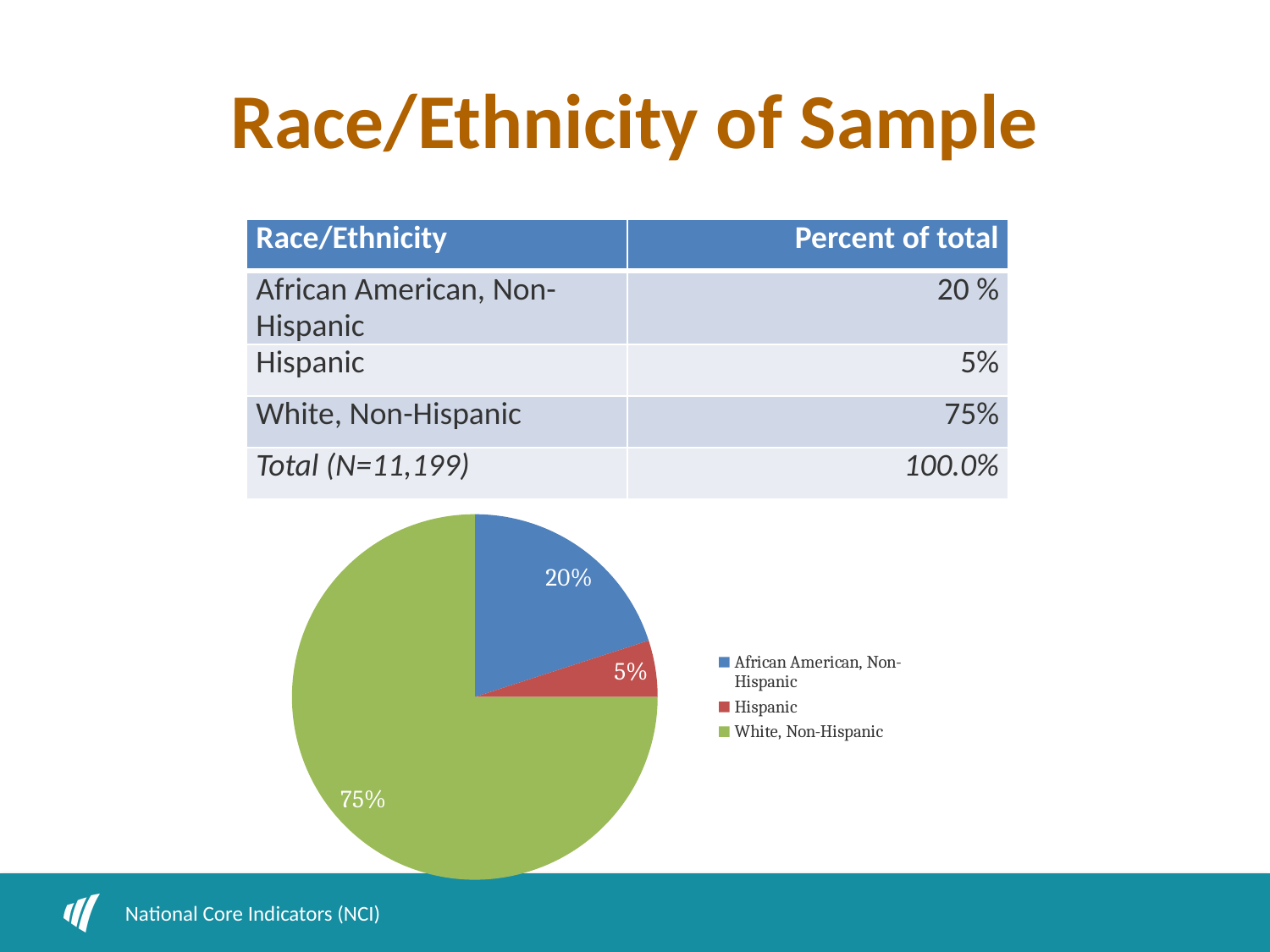
Which slice is larger: African American, Non-Hispanic or Hispanic? African American, Non-Hispanic Which category has the largest slice of the pie? White, Non-Hispanic What share of the pie does White, Non-Hispanic represent? 75% What is the difference in percentage points between the White, Non-Hispanic slice and the African American, Non-Hispanic slice? 55 What share of the pie does African American, Non-Hispanic represent? 20% How many slices does the pie chart have? 3 How many entries does the legend list? 3 What colour is the White, Non-Hispanic slice in the pie chart? green What share of the pie does Hispanic represent? 5% What kind of chart is shown on the slide? pie chart Which category has the smallest slice of the pie? Hispanic What colour is the Hispanic slice in the pie chart? red